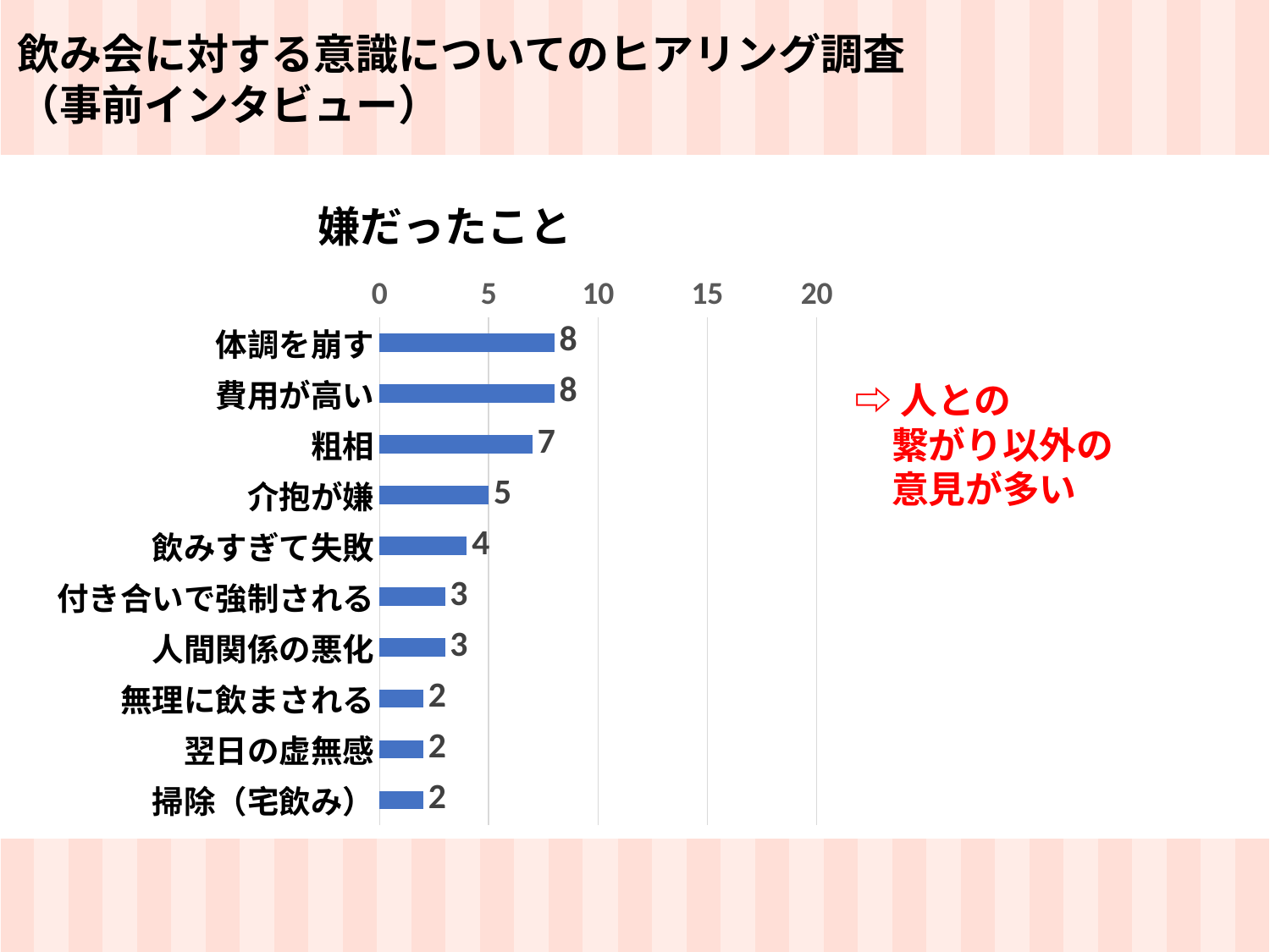
What is the value for 介抱が嫌? 5 Which category has the lowest value among 粗相, 介抱が嫌 and 飲みすぎて失敗? 飲みすぎて失敗 How many categories are shown in the chart? 10 What is the value for 翌日の虚無感? 2 What is the title of the chart? 嫌だったこと What kind of chart is shown on the slide? bar chart What is the value for 飲みすぎて失敗? 4 What is the difference between the values for 体調を崩す and 介抱が嫌? 3 Which is larger, the value for 費用が高い or the value for 付き合いで強制される? 費用が高い Is the value for 体調を崩す greater or less than 5? greater What is the value for 粗相? 7 What is the difference between the values for 粗相 and 掃除（宅飲み）? 5